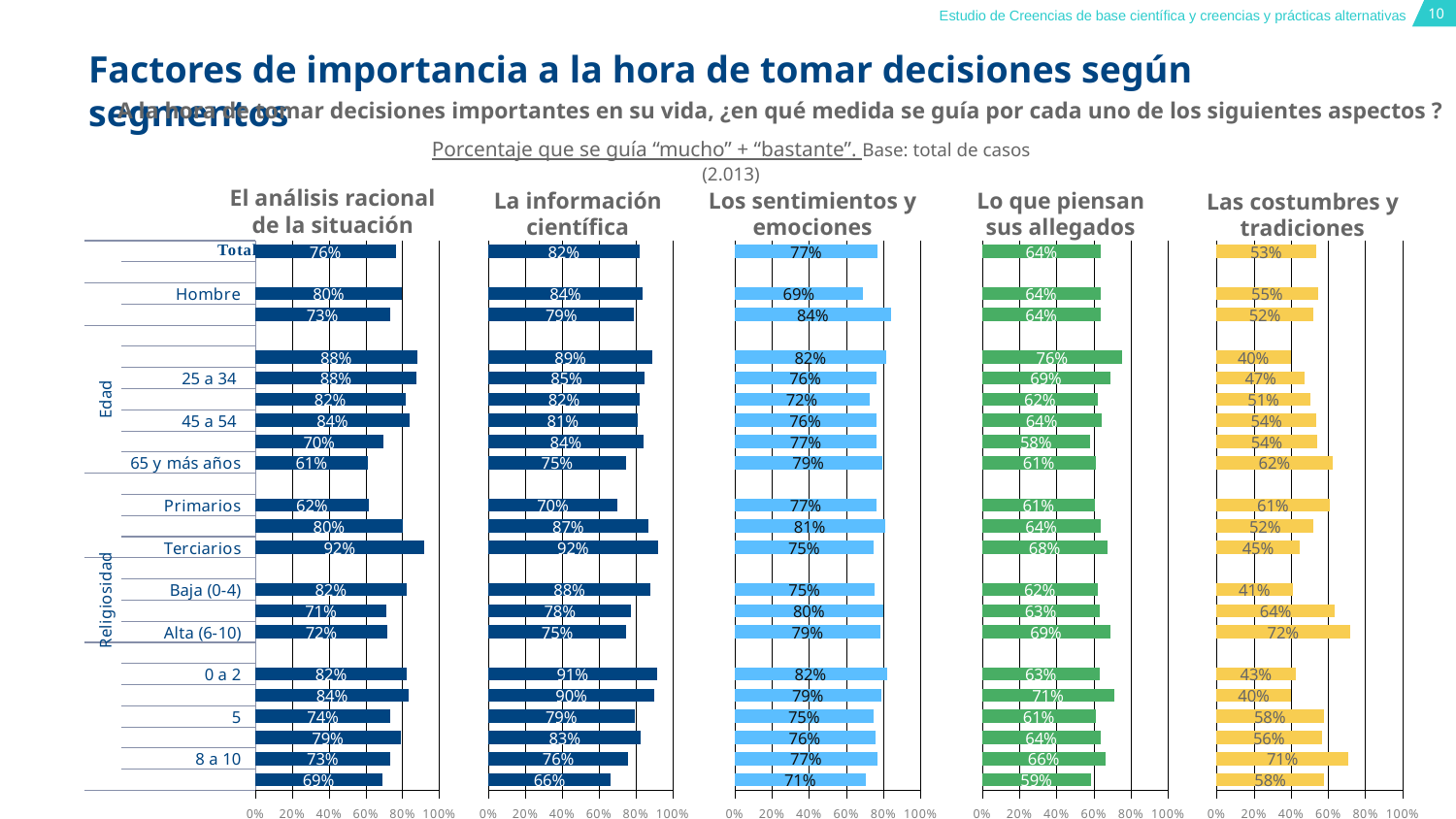
What kind of chart is used on this slide? Bar chart In the chart titled "Lo que piensan sus allegados", is the value for 25 a 34 greater or less than 60%? greater In the chart titled "Lo que piensan sus allegados", what is the value for 25 a 34? 69% How many charts are shown on the slide? 5 In the chart titled "La información científica", what is the value for Hombre? 84% In the chart titled "Las costumbres y tradiciones", which is larger, the value for Baja (0-4) or the value for Alta (6-10)? Alta (6-10) In the chart titled "El análisis racional de la situación", what is the value for Total? 76% In the chart titled "Las costumbres y tradiciones", what is the value for Alta (6-10)? 72% In the chart titled "La información científica", is the value for Primarios greater or less than 80%? less In the chart titled "Los sentimientos y emociones", what is the value for 65 y más años? 79% In the chart titled "El análisis racional de la situación", what is the difference between the values for Terciarios and Primarios? 30% In the chart titled "El análisis racional de la situación", what is the difference between the values for Hombre and Total? 4%